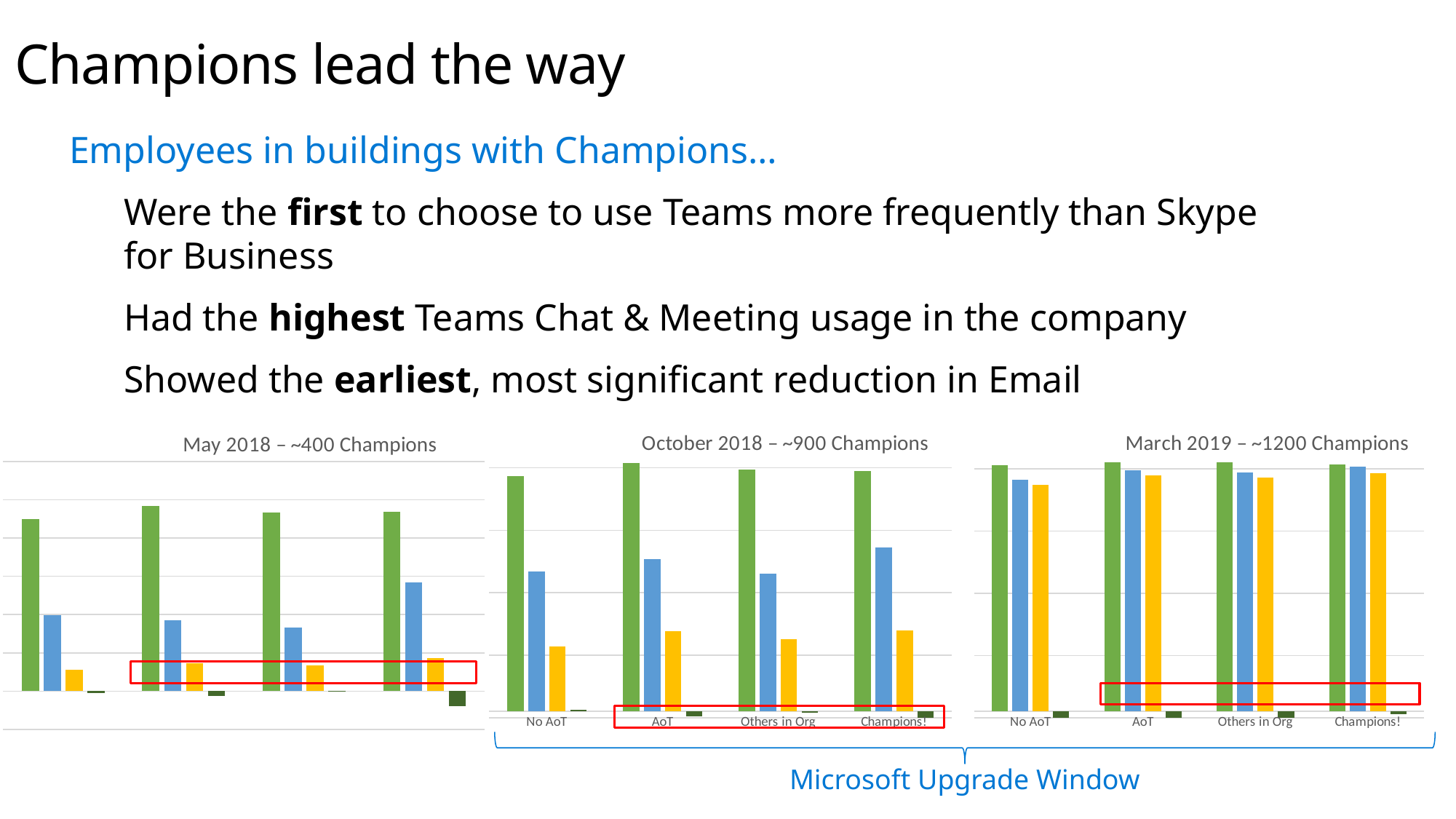
What is the title of the leftmost chart on the slide? May 2018 – ~400 Champions In the 'October 2018 – ~900 Champions' chart, which category has the tallest blue bar? Champions! How many categories are shown on the x axis of the 'March 2019 – ~1200 Champions' chart? 4 In the 'October 2018 – ~900 Champions' chart, is the yellow bar for Champions! taller or shorter than the yellow bar for No AoT? taller In the 'May 2018 – ~400 Champions' chart, which group of bars, counting from the left, has the tallest blue bar? the fourth (rightmost) group In the 'March 2019 – ~1200 Champions' chart, is the blue bar for No AoT taller or shorter than the blue bar for Champions!? shorter In the 'October 2018 – ~900 Champions' chart, which category has the shortest yellow bar? No AoT What kind of chart is the 'October 2018 – ~900 Champions' chart? bar chart What are the category labels on the x axis of the 'October 2018 – ~900 Champions' chart? No AoT, AoT, Others in Org, Champions! In the 'October 2018 – ~900 Champions' chart, which category has the shortest blue bar? Others in Org In the 'October 2018 – ~900 Champions' chart, is the green bar or the blue bar taller for Champions!? green In the 'March 2019 – ~1200 Champions' chart, do the blue bars rise or fall from No AoT to Champions!? rise